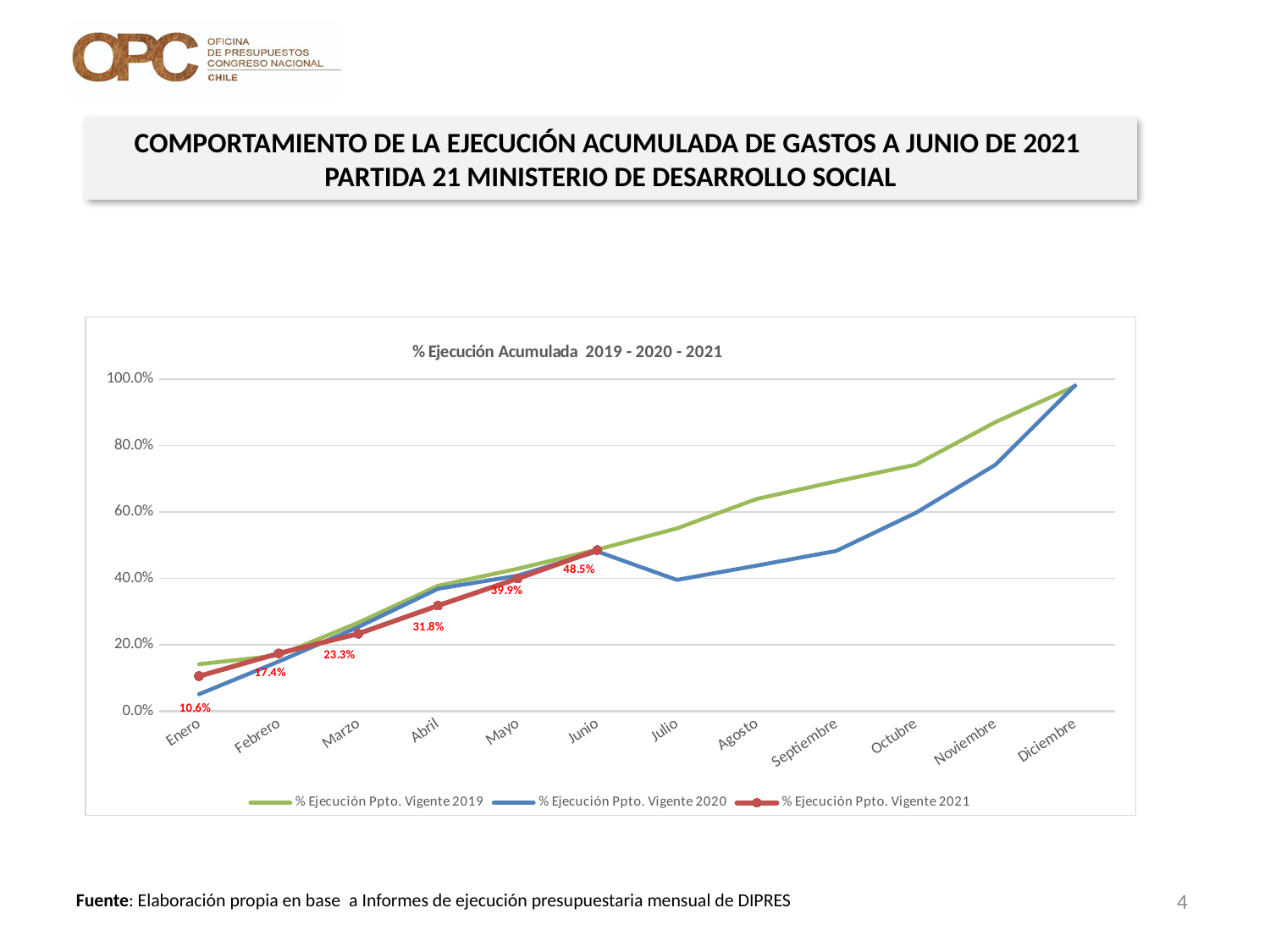
What is the value of % Ejecución Ppto. Vigente 2021 for Abril? 31.8% What is the value of % Ejecución Ppto. Vigente 2021 for Enero? 10.6% In Octubre, which series is higher: % Ejecución Ppto. Vigente 2019 or % Ejecución Ppto. Vigente 2020? % Ejecución Ppto. Vigente 2019 How many series does the legend list? 3 Which month has the lowest labelled value for the % Ejecución Ppto. Vigente 2021 series? Enero Which month has the highest labelled value for the % Ejecución Ppto. Vigente 2021 series? Junio What is the difference between the 2021 values for Mayo and Abril? 8.1 percentage points What kind of chart is shown on the slide? Line chart How many months are shown on the x axis? 12 What is the value of % Ejecución Ppto. Vigente 2021 for Junio? 48.5% Is the value for % Ejecución Ppto. Vigente 2019 in Octubre greater or less than 60.0%? greater What is the difference between the 2021 values for Junio and Enero? 37.9 percentage points